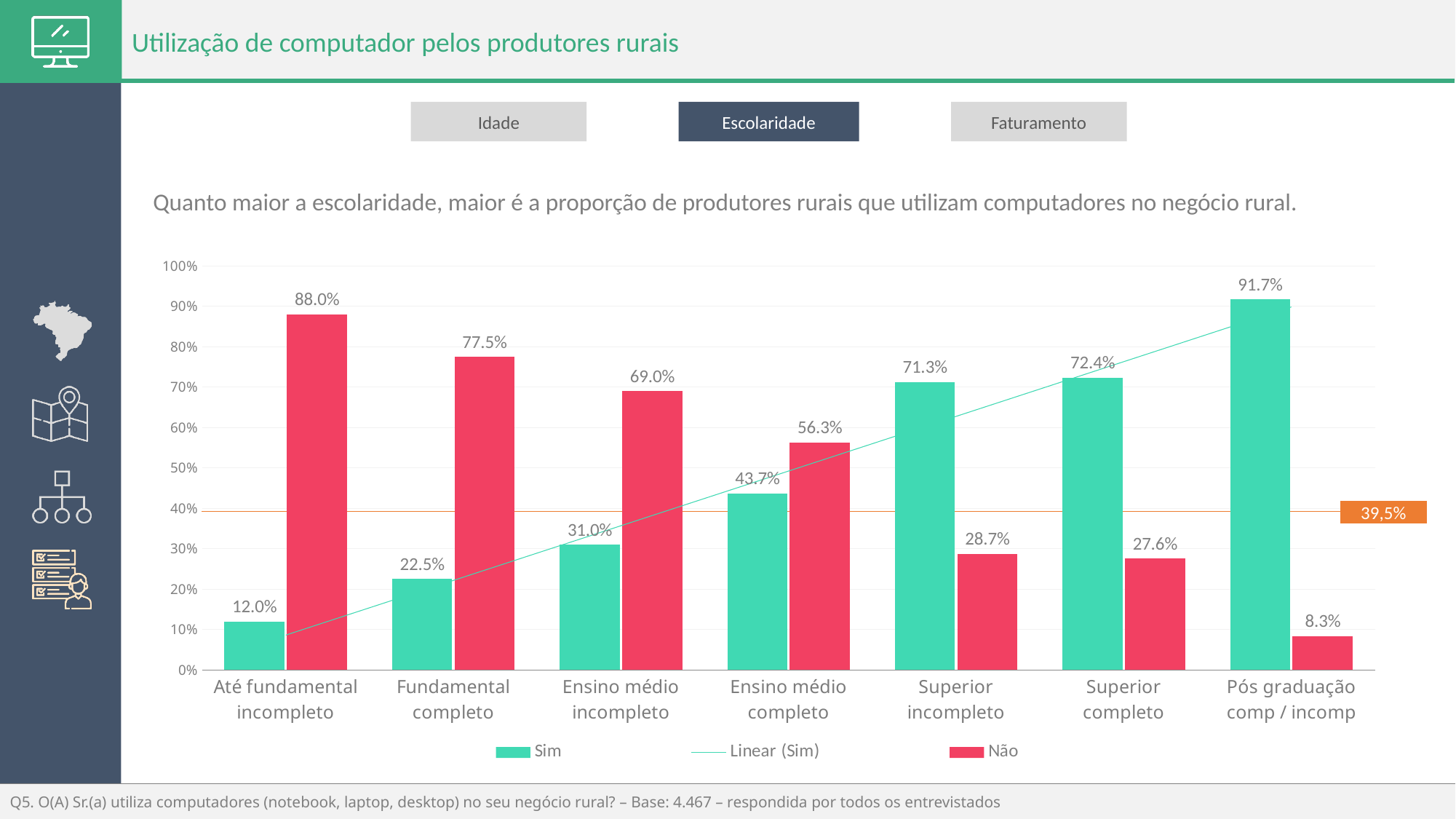
How many education categories are shown on the x axis? 7 What is the difference between the 'Não' and 'Sim' values for 'Até fundamental incompleto'? 76.0% What is the 'Sim' value for 'Ensino médio completo'? 43.7% How many entries does the legend list? 3 Do the 'Sim' values generally rise or fall as education level increases along the x axis? rise Which category has the highest 'Sim' value? Pós graduação comp / incomp What kind of chart is shown on the slide? bar chart Is the 'Sim' value for 'Ensino médio incompleto' greater or less than 40%? less Which category has the lowest 'Não' value? Pós graduação comp / incomp What is the 'Não' value for 'Fundamental completo'? 77.5% What value is shown on the orange horizontal reference line? 39,5% Which is larger: the 'Sim' value for 'Superior completo' or the 'Sim' value for 'Superior incompleto'? Superior completo